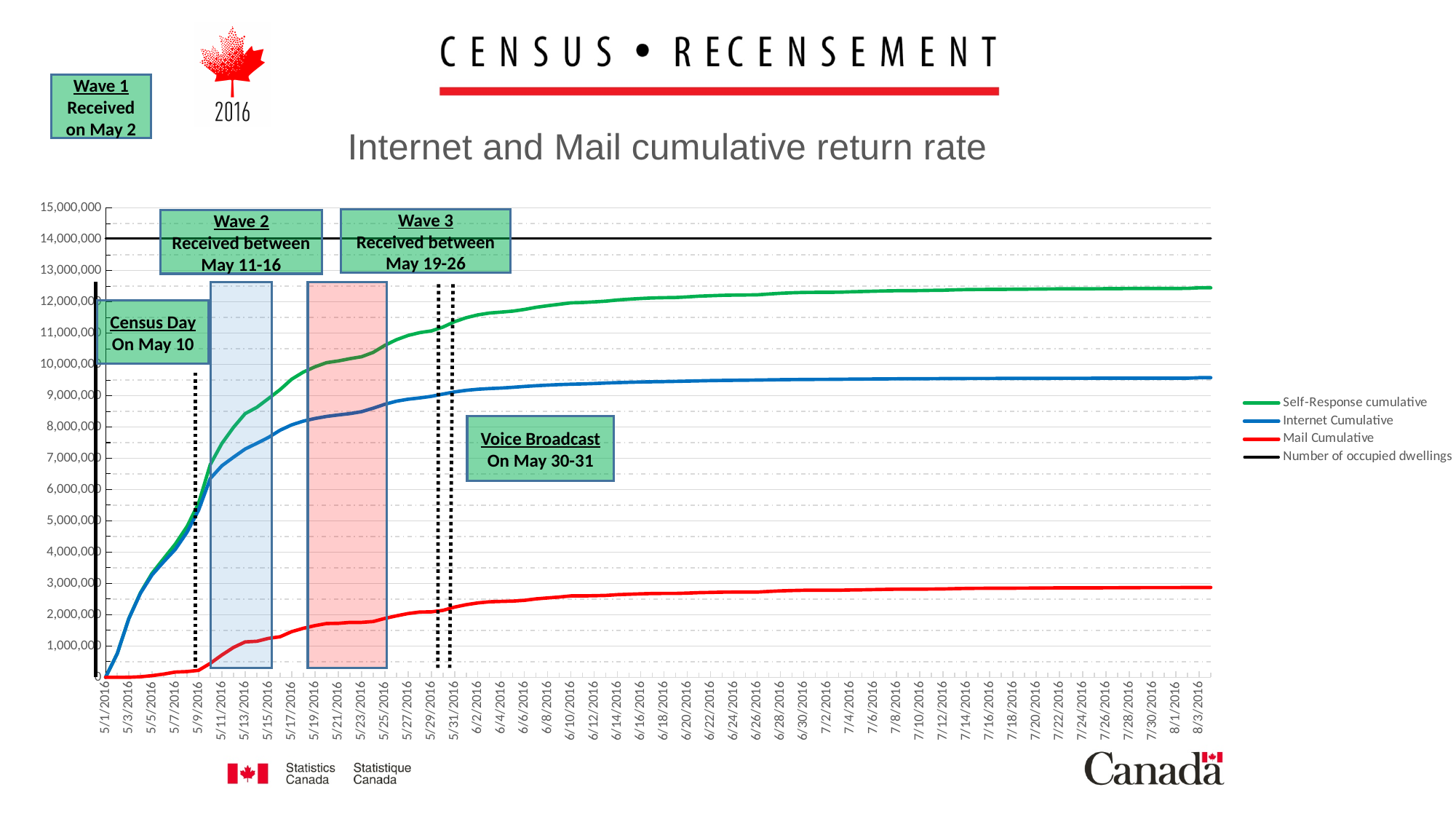
How many series does the chart legend list? 4 On 5/11/2016, is the Self-Response cumulative value greater or less than 6,000,000? greater Which of the three cumulative series is lowest on 8/3/2016? Mail Cumulative What colour is the Internet Cumulative line? blue What is the title of the chart? Internet and Mail cumulative return rate What kind of chart is shown on the slide? line chart Which of the three cumulative series is highest on 8/3/2016? Self-Response cumulative Which is larger on 6/30/2016, Internet Cumulative or Mail Cumulative? Internet Cumulative On 8/3/2016, is the Internet Cumulative value greater or less than 9,000,000? greater Does the Mail Cumulative line rise or fall from 5/1/2016 to 8/3/2016? rise On 8/3/2016, is the Mail Cumulative value greater or less than 2,000,000? greater